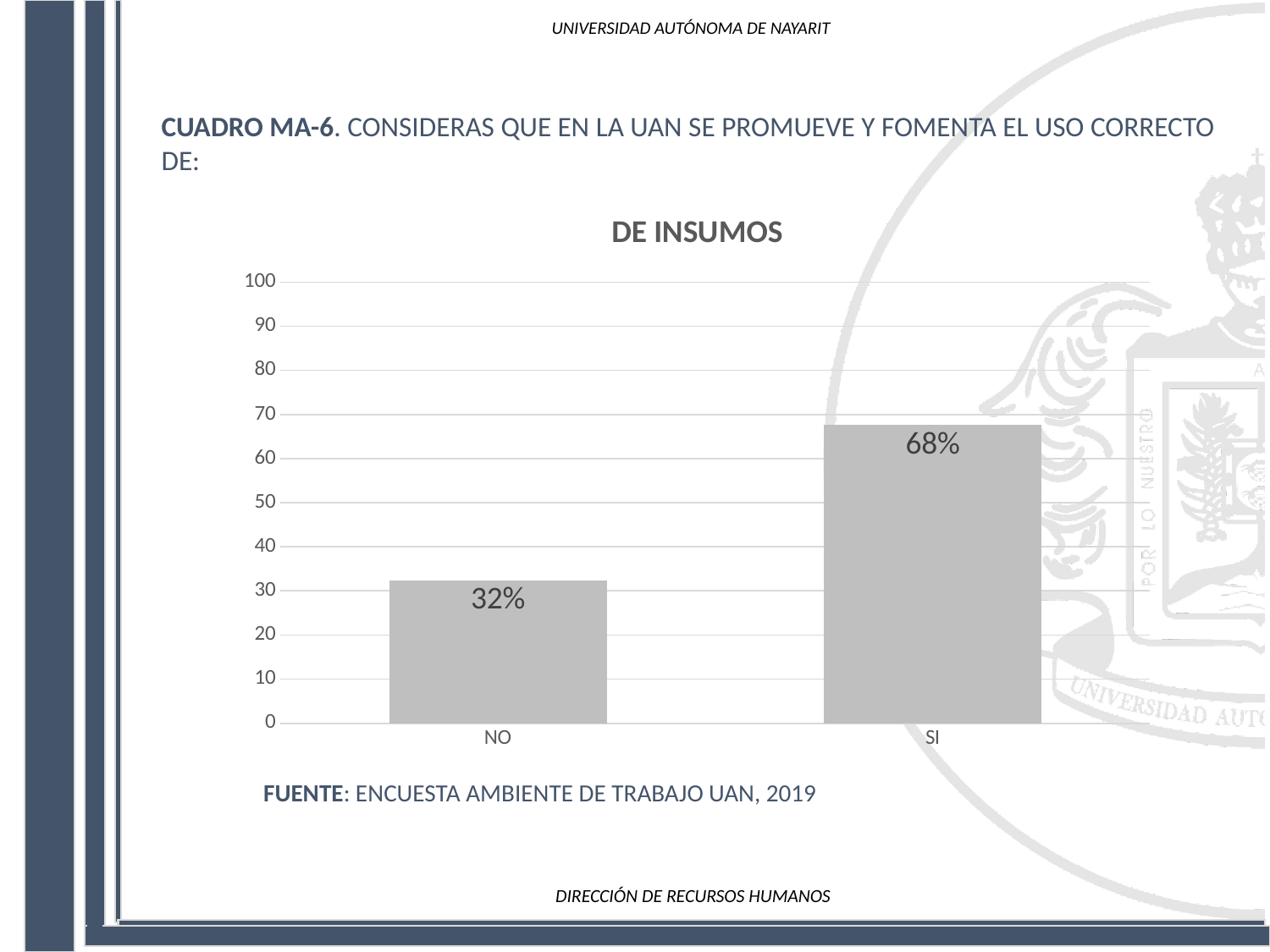
What is the value for SI? 68% Is the value for NO greater or less than 40? less What kind of chart is shown? bar chart How many categories are shown on the x axis? 2 What is the value for NO? 32% What is the title of the chart? DE INSUMOS Which is larger, the value for NO or the value for SI? SI Which category has the lowest value? NO Is the value for SI greater or less than 60? greater What is the maximum value shown on the vertical axis? 100 Which category has the highest value? SI What is the difference between the values for SI and NO? 36%